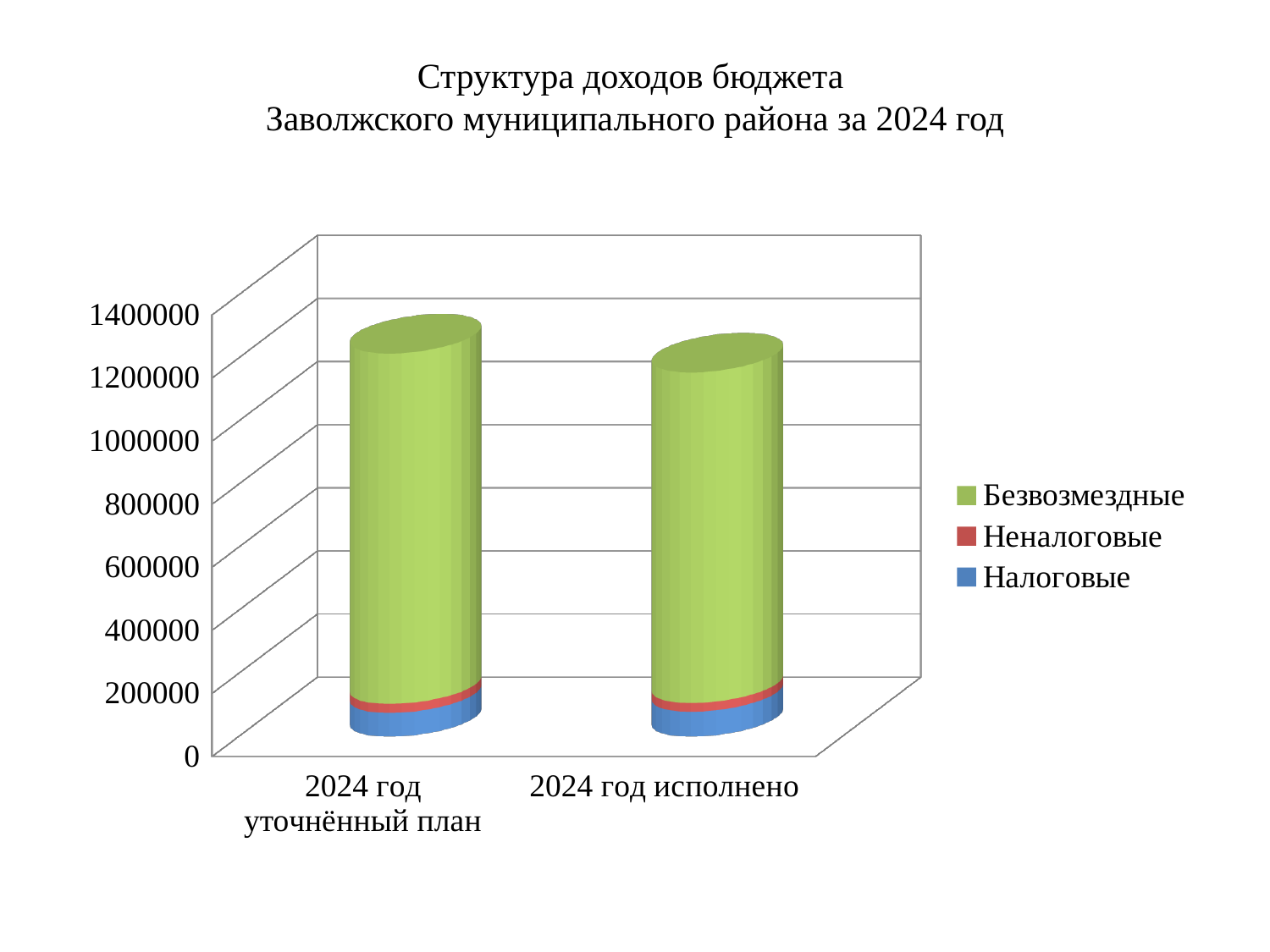
Which series is shown in green in the legend? Безвозмездные What is the title of the chart? Структура доходов бюджета Заволжского муниципального района за 2024 год Which series makes up the largest part of the bar for '2024 год исполнено'? Безвозмездные Do the total bar values rise or fall from '2024 год уточнённый план' to '2024 год исполнено'? fall Is the value of 'Налоговые' for '2024 год исполнено' greater or less than 400000? less Is the total value for '2024 год исполнено' greater or less than 1000000? greater How many series does the legend list? 3 How many categories are shown on the x axis of the chart? 2 Is the total value for '2024 год уточнённый план' greater or less than 1000000? greater Which series makes up the smallest part of the bar for '2024 год уточнённый план'? Неналоговые What kind of chart is shown on the slide? bar chart Which category has the higher total bar: '2024 год уточнённый план' or '2024 год исполнено'? 2024 год уточнённый план